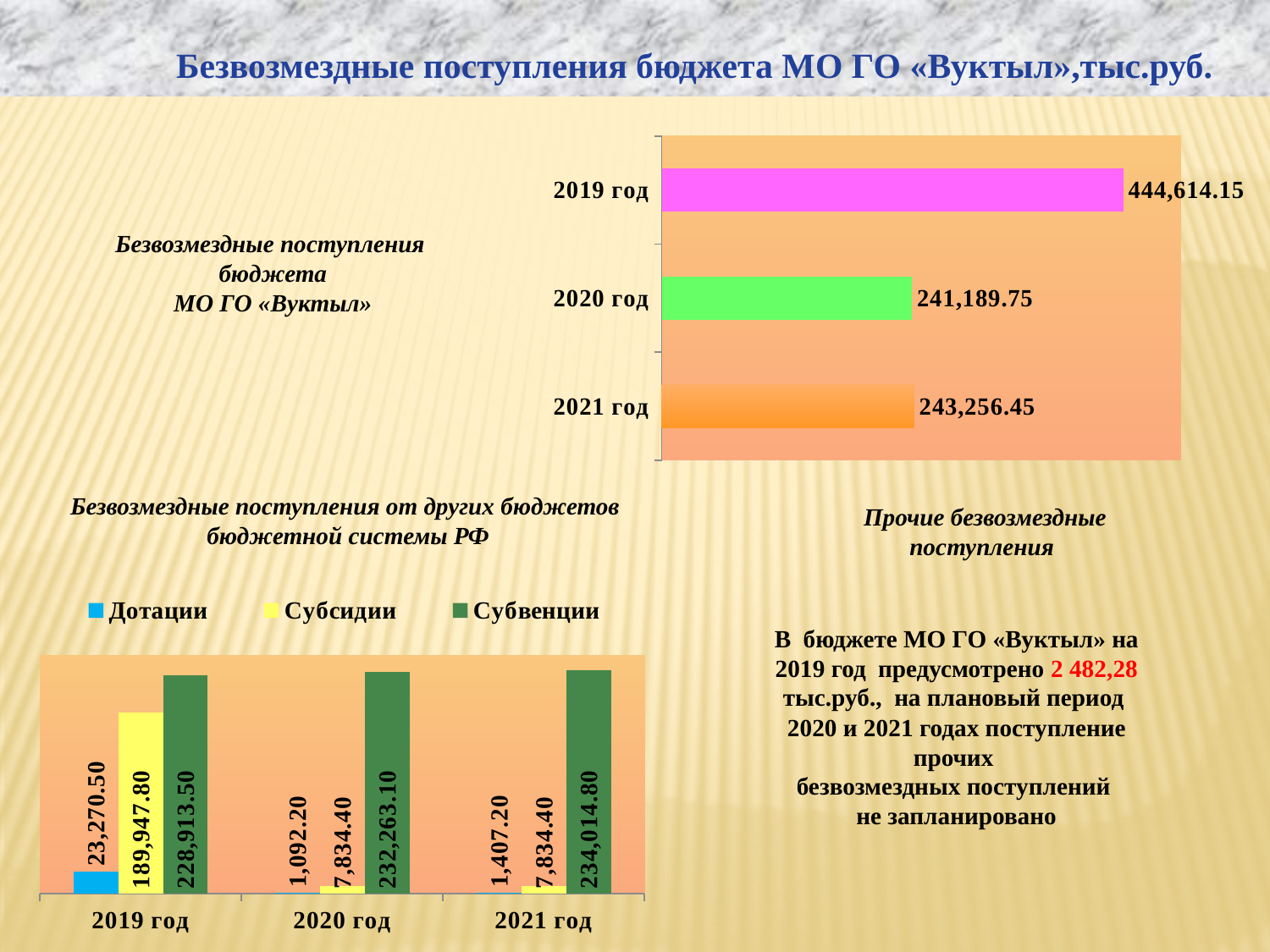
In the top-right chart 'Безвозмездные поступления бюджета МО ГО «Вуктыл»', how many years are shown? 3 What kind of chart is the top-right chart 'Безвозмездные поступления бюджета МО ГО «Вуктыл»'? Bar chart In the top-right chart 'Безвозмездные поступления бюджета МО ГО «Вуктыл»', what is the value for 2019 год? 444,614.15 In the top-right chart 'Безвозмездные поступления бюджета МО ГО «Вуктыл»', what is the value for 2021 год? 243,256.45 In the bottom-left chart 'Безвозмездные поступления от других бюджетов бюджетной системы РФ', what is the value of Субвенции for 2021 год? 234,014.80 In the bottom-left chart 'Безвозмездные поступления от других бюджетов бюджетной системы РФ', which is larger: Дотации in 2019 год or Дотации in 2021 год? Дотации in 2019 год In the bottom-left chart 'Безвозмездные поступления от других бюджетов бюджетной системы РФ', which series has the lowest value in 2020 год? Дотации In the bottom-left chart 'Безвозмездные поступления от других бюджетов бюджетной системы РФ', how many series does the legend list? 3 In the top-right chart 'Безвозмездные поступления бюджета МО ГО «Вуктыл»', which year has the highest value? 2019 год In the bottom-left chart 'Безвозмездные поступления от других бюджетов бюджетной системы РФ', what is the difference between Субвенции in 2021 год and Субвенции in 2020 год? 1,751.70 In the top-right chart 'Безвозмездные поступления бюджета МО ГО «Вуктыл»', what is the difference between the 2019 год and 2020 год values? 203,424.40 In the bottom-left chart 'Безвозмездные поступления от других бюджетов бюджетной системы РФ', what is the value of Субсидии for 2019 год? 189,947.80